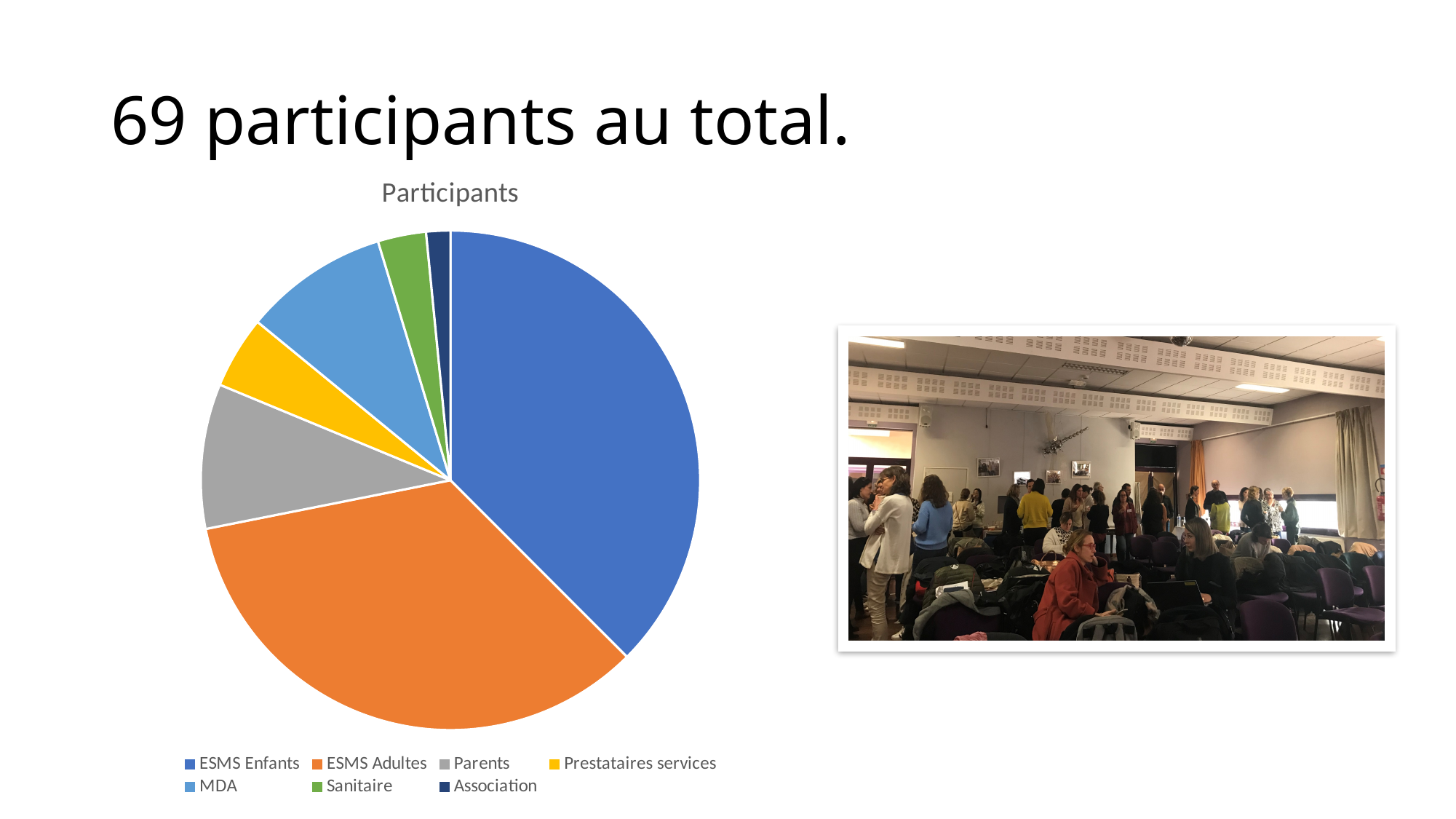
Which slice is larger, ESMS Adultes or Parents? ESMS Adultes Which category has the largest slice of the pie chart? ESMS Enfants Which category is shown in yellow in the pie chart legend? Prestataires services Which slice is larger, Parents or Prestataires services? Parents Which slice is larger, Sanitaire or Association? Sanitaire Which category has the smallest slice of the pie chart? Association How many categories (slices) does the pie chart have? 7 What kind of chart is shown on the slide? Pie chart What is the title of the pie chart? Participants